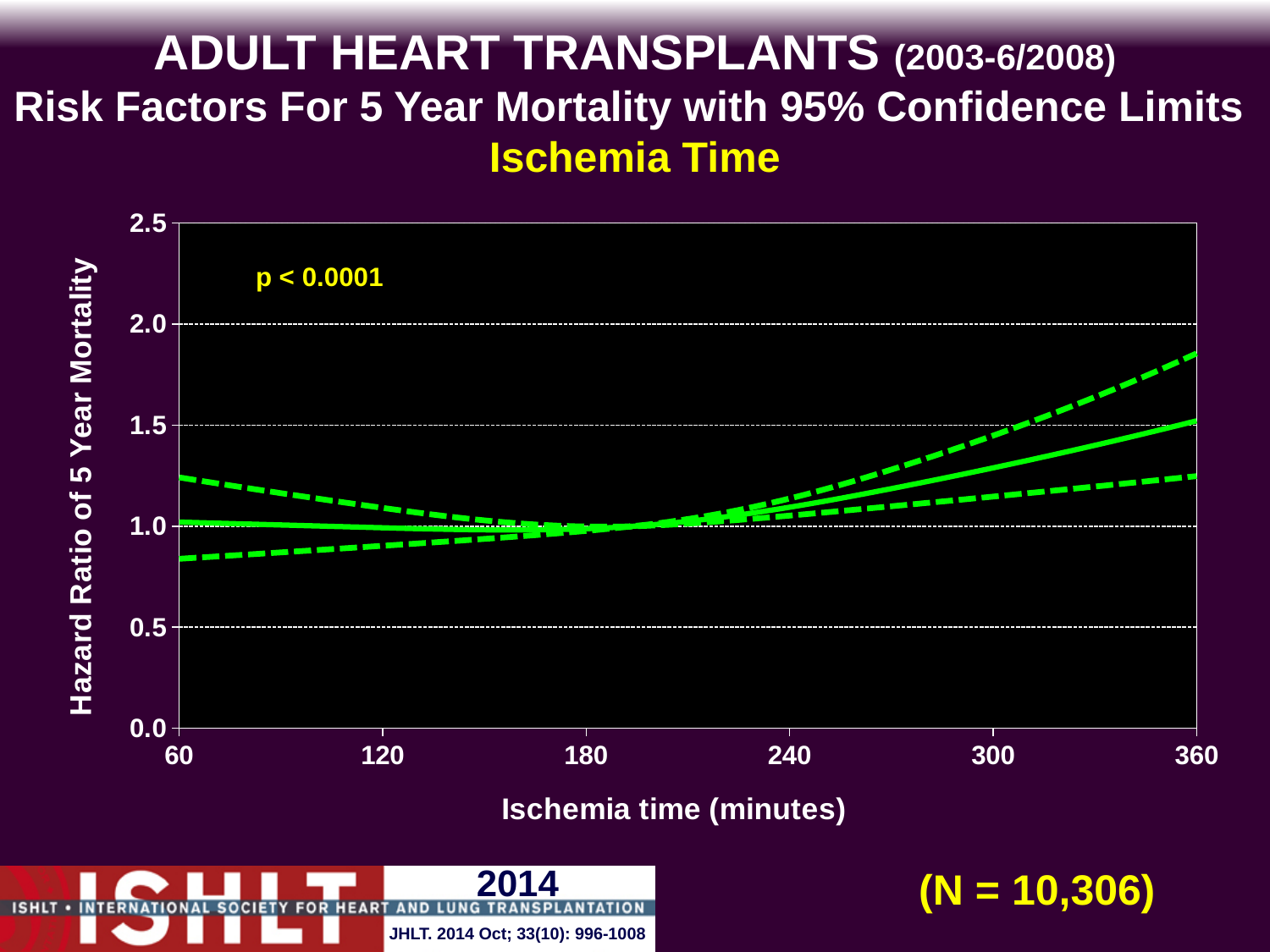
Is the lower dashed confidence limit at 60 minutes greater or less than 1.0? less What kind of chart is shown on the slide? line chart Does the solid hazard ratio line rise or fall as ischemia time increases from 180 to 360 minutes? rise What is the label of the x axis? Ischemia time (minutes) Is the upper dashed confidence limit at 360 minutes greater or less than 1.5? greater Does the solid hazard ratio line rise or fall as ischemia time increases from 60 to 180 minutes? fall Is the upper dashed confidence limit at 60 minutes greater or less than 1.0? greater What p-value is printed on the chart? p < 0.0001 At 360 minutes, which is larger: the upper dashed confidence limit or the lower dashed confidence limit? upper dashed confidence limit How many lines are plotted on the chart? 3